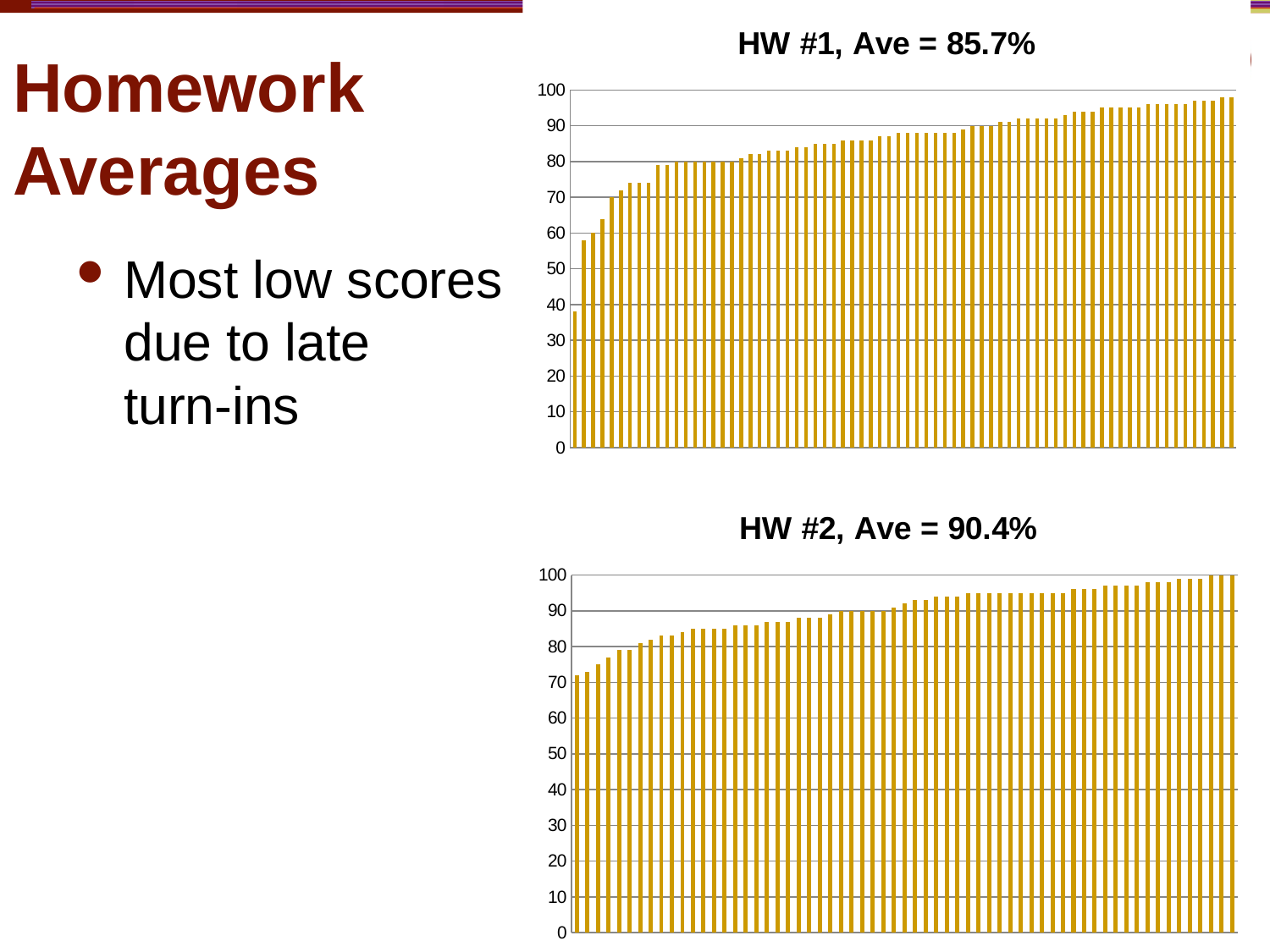
What is the maximum value shown on the vertical axis of the 'HW #1, Ave = 85.7%' chart? 100 According to the chart titles, which homework has the higher average, HW #1 or HW #2? HW #2 What kind of chart is the 'HW #1, Ave = 85.7%' chart? bar chart In the 'HW #2, Ave = 90.4%' chart, is the value of the rightmost (highest) bar greater or less than 90? greater In the 'HW #2, Ave = 90.4%' chart, do the bar values rise or fall from left to right? rise In the 'HW #2, Ave = 90.4%' chart, is the value of the leftmost (lowest) bar greater or less than 60? greater In the 'HW #1, Ave = 85.7%' chart, is the value of the leftmost (lowest) bar greater or less than 50? less What kind of chart is the 'HW #2, Ave = 90.4%' chart? bar chart In the 'HW #1, Ave = 85.7%' chart, do the bar values rise or fall from left to right? rise